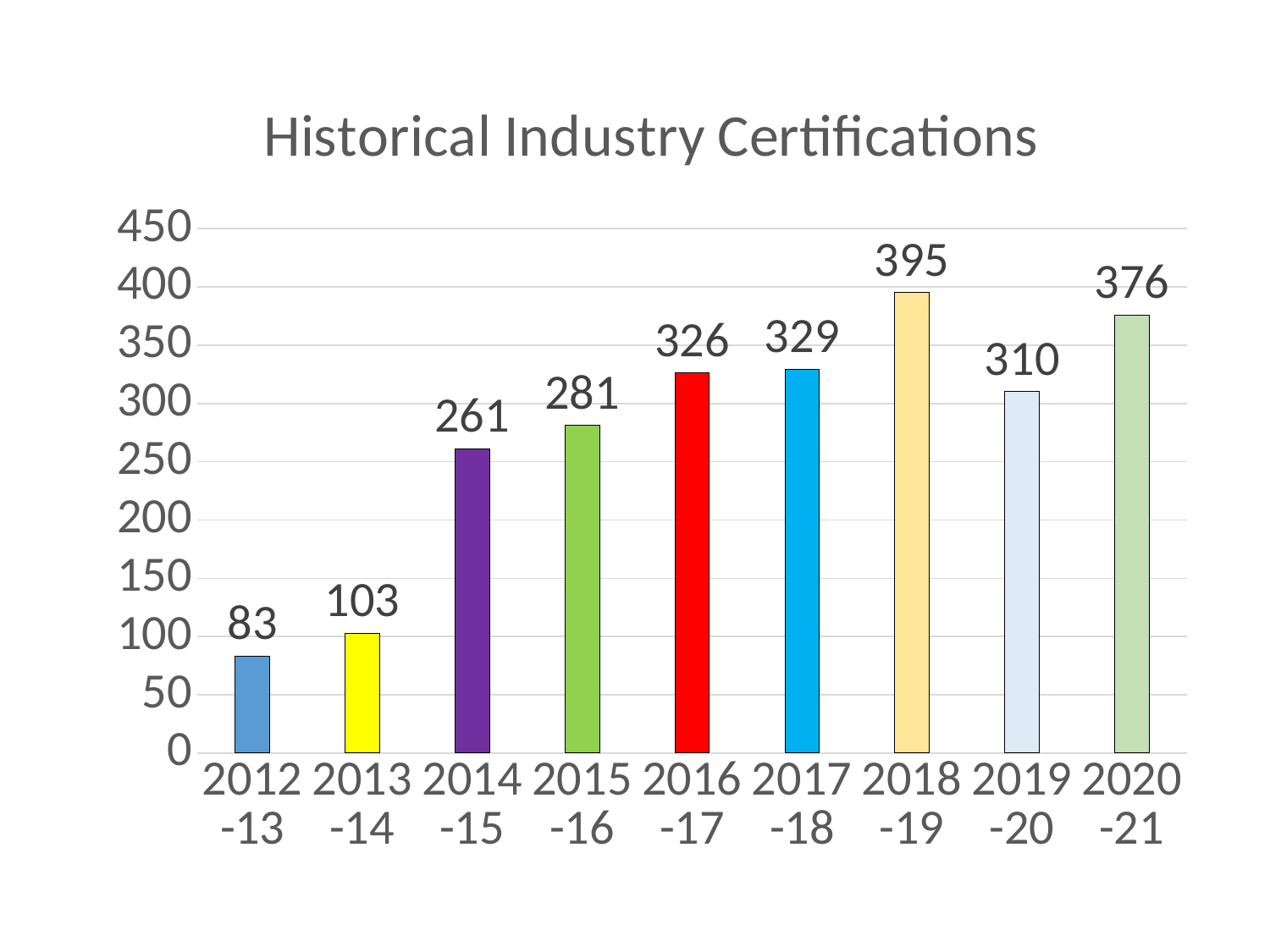
What is the difference between the values for 2014-15 and 2013-14? 158 What is the value for 2018-19? 395 What is the title of the chart? Historical Industry Certifications Is the value for 2017-18 greater or less than 300? greater Which is larger, the value for 2016-17 or the value for 2019-20? 2016-17 What is the difference between the values for 2020-21 and 2019-20? 66 Which year has the highest number of certifications? 2018-19 What kind of chart is shown on the slide? bar chart What is the value for 2015-16? 281 How many years are shown on the x axis? 9 What is the value for 2012-13? 83 Which year has the lowest number of certifications? 2012-13